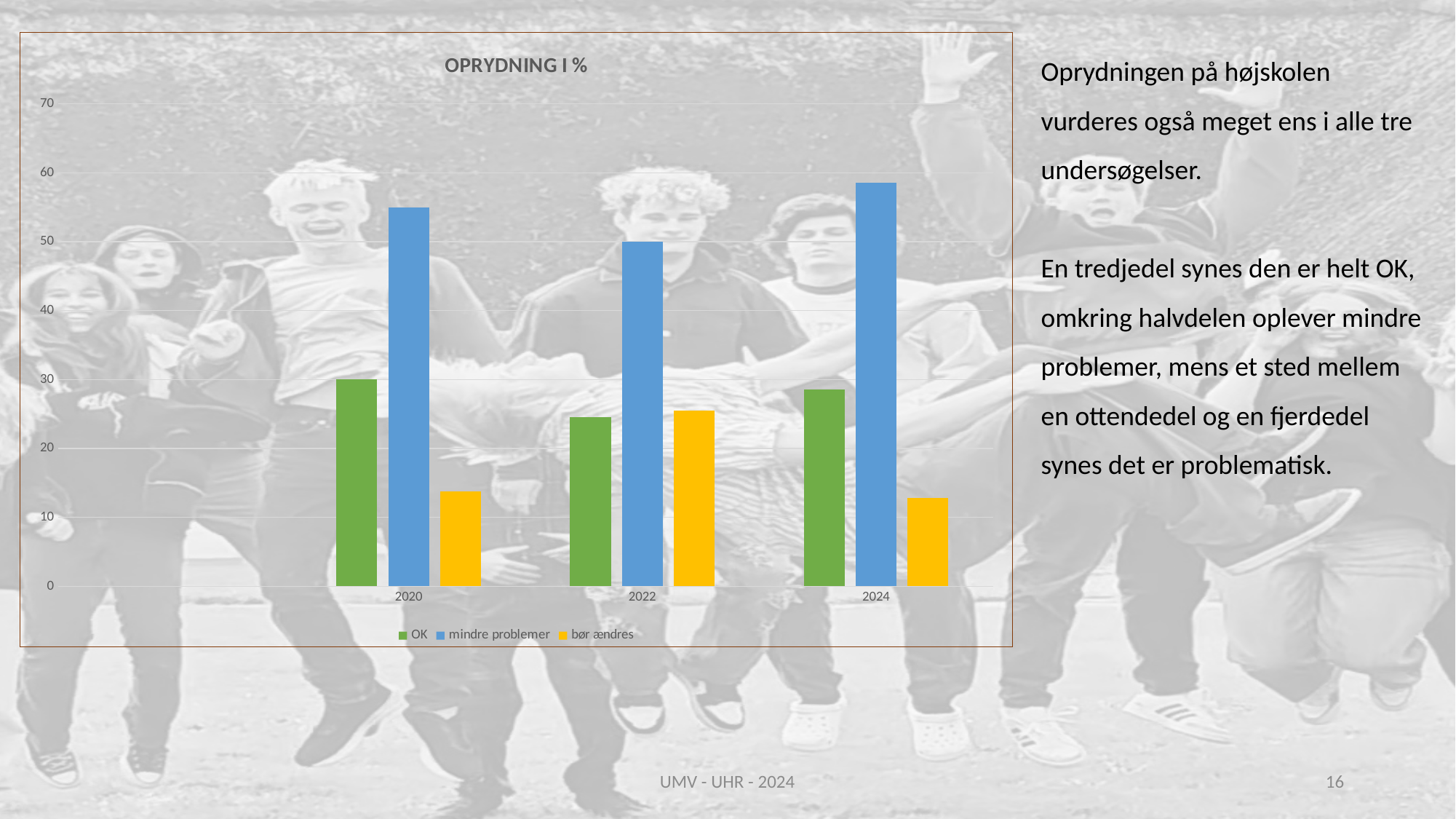
Is the value for mindre problemer in 2020 greater or less than 50? greater What kind of chart is shown on the slide? bar chart How many series does the legend list? 3 What is the title of the chart? OPRYDNING I % Is the value for bør ændres in 2020 greater or less than 20? less How many years are shown on the x axis of the chart? 3 Which series has the highest value in 2020? mindre problemer Which series has the lowest value in 2024? bør ændres Does the value for bør ændres rise or fall from 2022 to 2024? fall Which is larger: bør ændres in 2020 or bør ændres in 2022? 2022 Is the value for OK in 2022 greater or less than 30? less Which series is shown in blue in the chart? mindre problemer